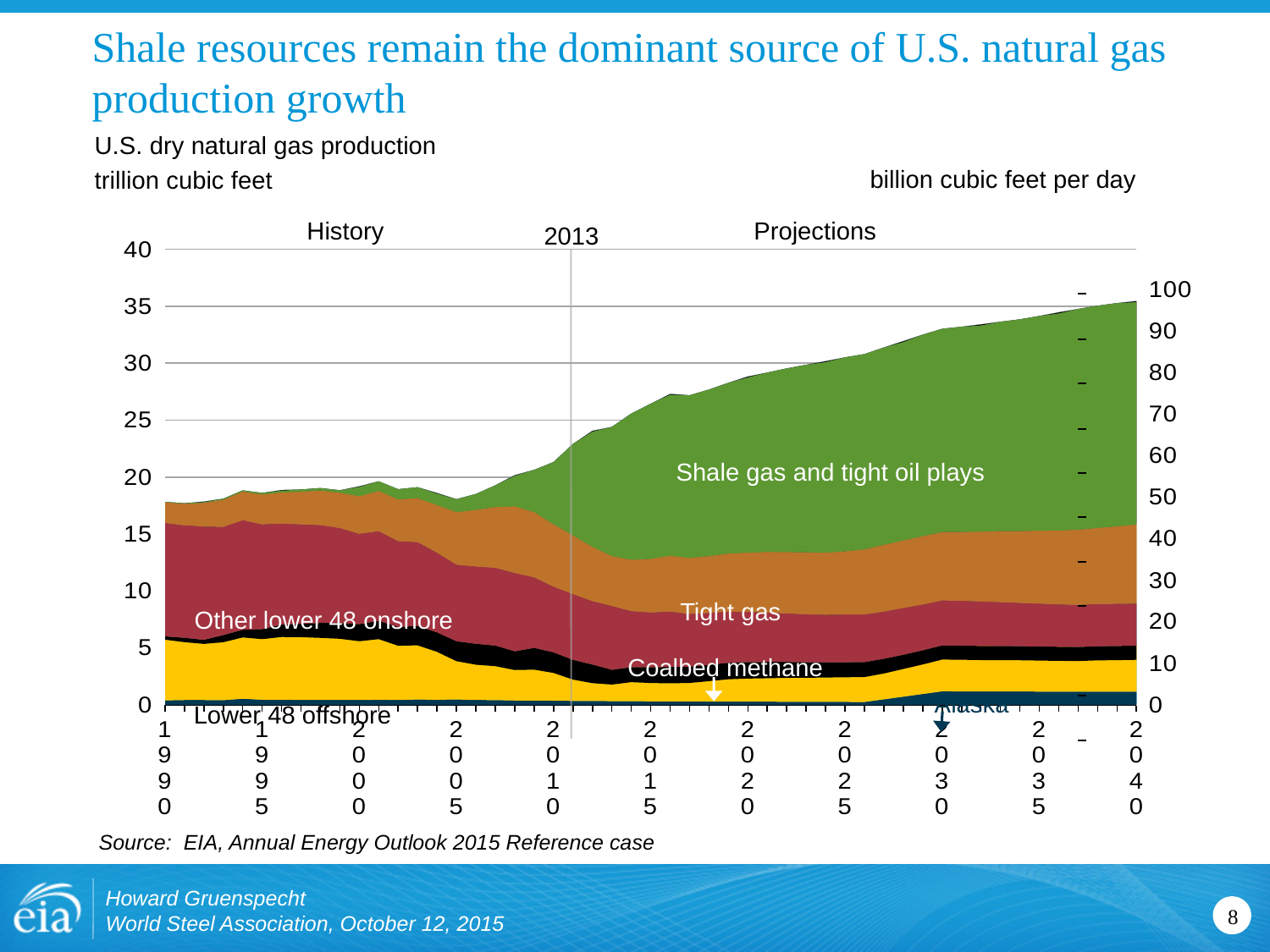
Is total U.S. dry natural gas production in 2040 greater or less than 30 trillion cubic feet? greater What is the highest value shown on the right vertical axis (billion cubic feet per day)? 100 Which year separates the History and Projections sections of the chart? 2013 Which production source occupies the largest area of the chart in the projection years? Shale gas and tight oil plays What is the title of the chart on the slide? U.S. dry natural gas production What kind of chart is shown on the slide? Stacked area chart How many year labels are shown along the x axis of the chart? 11 Is total U.S. dry natural gas production in 2013 greater or less than 20 trillion cubic feet? greater Does total U.S. dry natural gas production rise or fall between 2013 and 2040? rise What unit is shown on the left vertical axis of the chart? trillion cubic feet Does the Other lower 48 onshore area grow or shrink between 2005 and 2015? shrink Is total U.S. dry natural gas production in 1990 greater or less than 20 trillion cubic feet? less